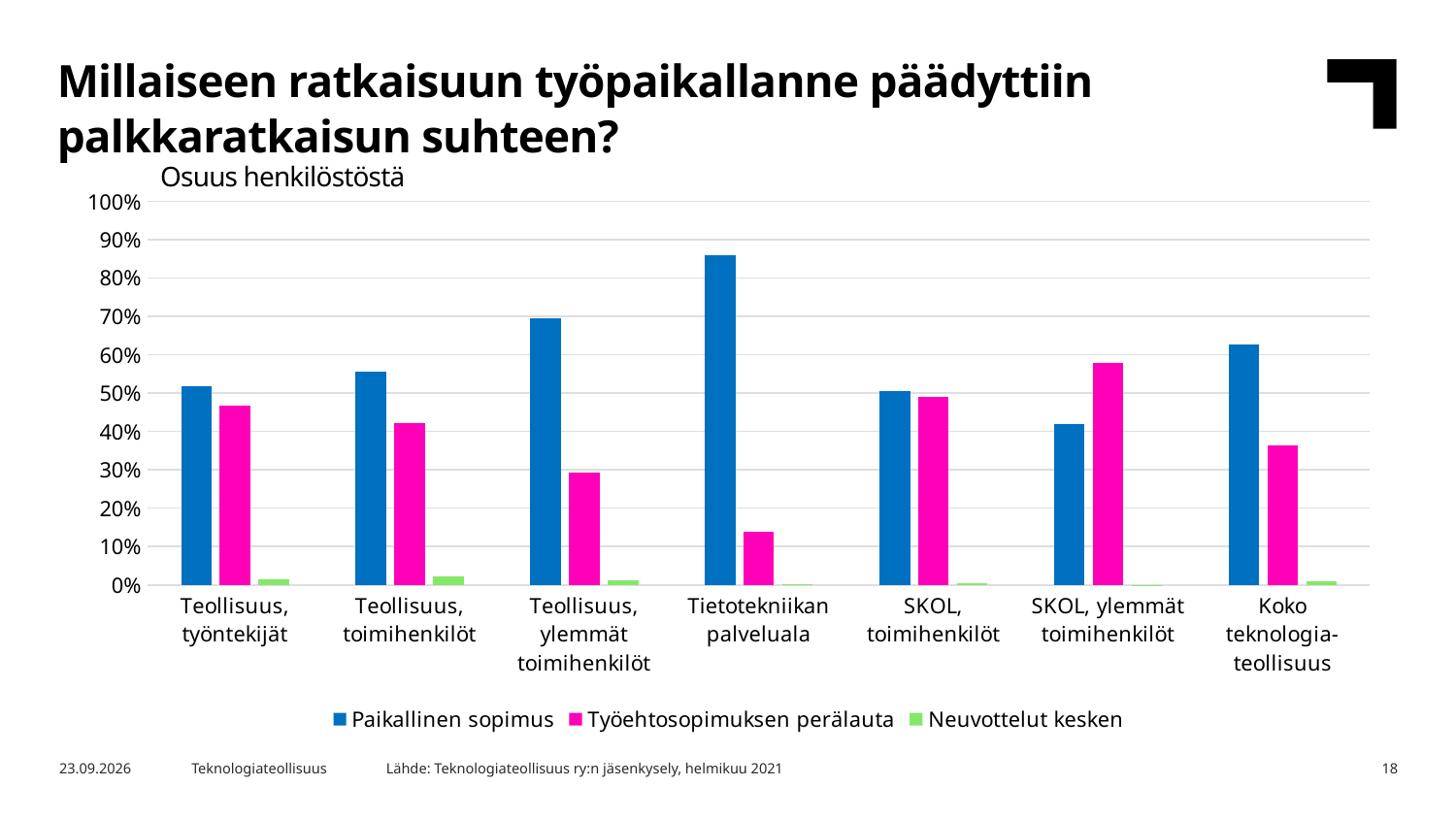
What kind of chart is shown on the slide? bar chart Which category has the highest value for Työehtosopimuksen perälauta? SKOL, ylemmät toimihenkilöt Which category has the lowest value for Työehtosopimuksen perälauta? Tietotekniikan palveluala Is the value for Paikallinen sopimus in Koko teknologiateollisuus greater or less than 60%? greater How many categories are shown on the x axis of the chart? 7 Which category has the highest value for Paikallinen sopimus? Tietotekniikan palveluala Which category has the lowest value for Paikallinen sopimus? SKOL, ylemmät toimihenkilöt How many series does the legend list? 3 What label is shown above the y axis of the chart? Osuus henkilöstöstä In SKOL, ylemmät toimihenkilöt, which is larger: Paikallinen sopimus or Työehtosopimuksen perälauta? Työehtosopimuksen perälauta Is the value for Työehtosopimuksen perälauta in Teollisuus, ylemmät toimihenkilöt greater or less than 40%? less Is the value for Paikallinen sopimus in Tietotekniikan palveluala greater or less than 80%? greater